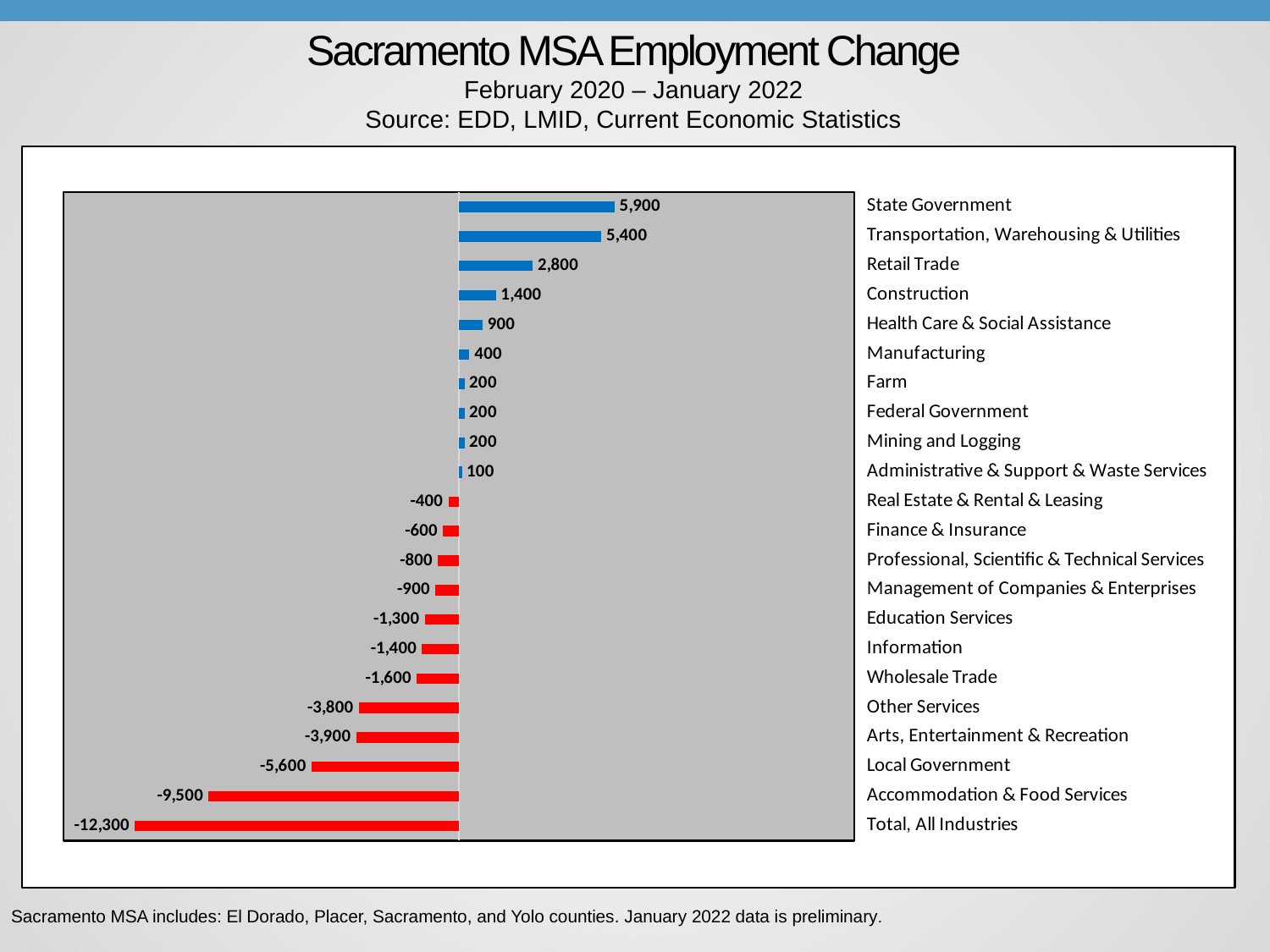
Which has a larger employment gain, Construction or Health Care & Social Assistance? Construction Excluding Total, All Industries, which industry has the largest negative employment change? Accommodation & Food Services What is the employment change for Total, All Industries? -12,300 What is the employment change for Retail Trade? 2,800 What is the difference between the employment change for State Government and Transportation, Warehousing & Utilities? 500 What kind of chart is shown on the slide? Bar chart What is the employment change for Accommodation & Food Services? -9,500 What colour are the bars for industries with negative employment change? Red What is the employment change for Local Government? -5,600 Which industry has the largest positive employment change? State Government What is the employment change for State Government? 5,900 How many categories are shown in the chart? 22